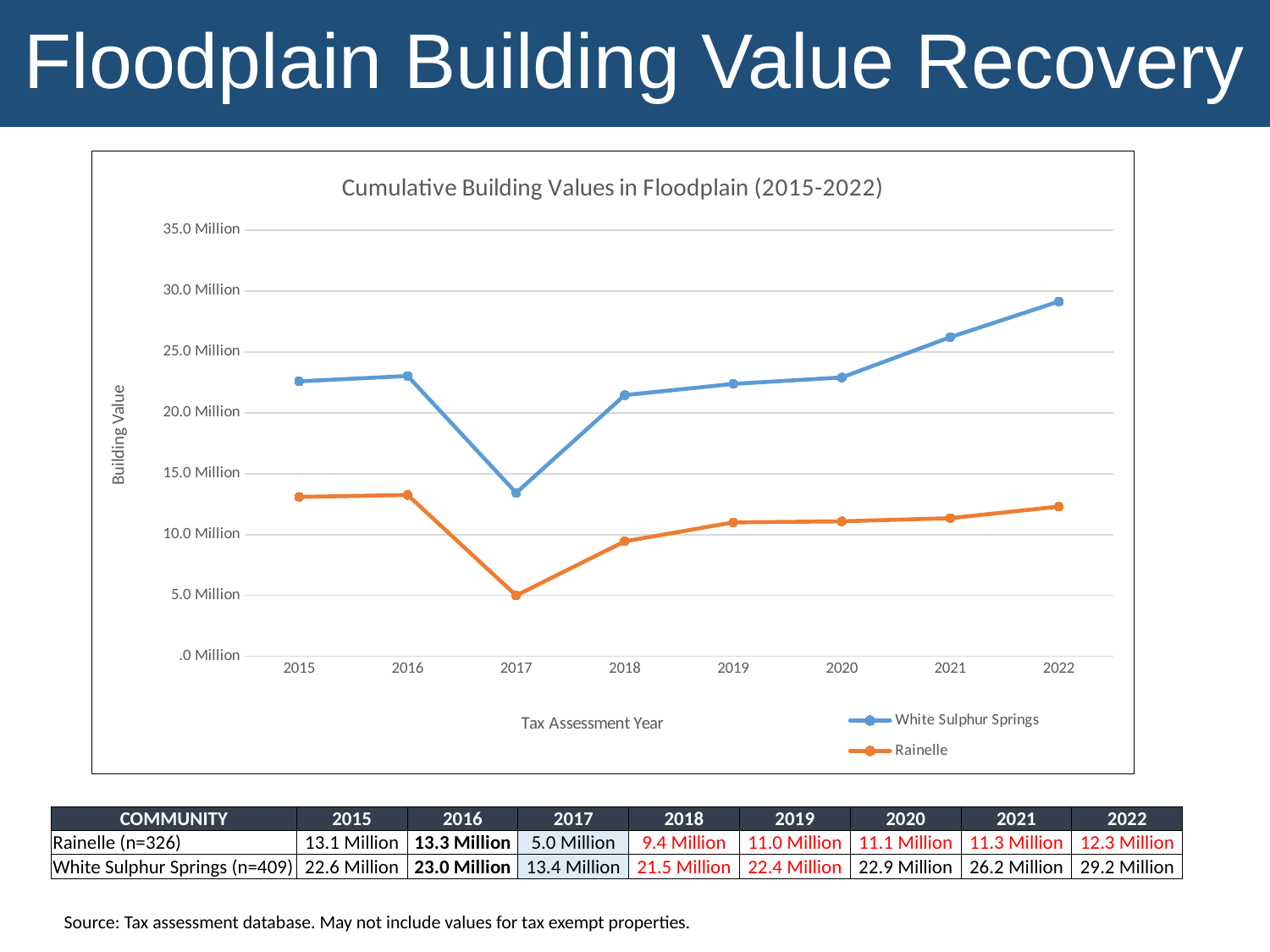
Which community has the larger building value in 2020, White Sulphur Springs or Rainelle? White Sulphur Springs In which year is the Rainelle building value highest? 2016 From 2017 to 2022, does the Rainelle building value rise or fall? rise In which year is the White Sulphur Springs building value lowest? 2017 What kind of chart is shown on the slide? line chart How many series does the chart legend list? 2 Is the White Sulphur Springs building value in 2021 greater or less than 25.0 Million? greater What is the title of the chart? Cumulative Building Values in Floodplain (2015-2022) What is the difference between the White Sulphur Springs and Rainelle building values in 2016? 9.7 Million What is the building value for Rainelle in 2017? 5.0 Million How many years are plotted along the x axis of the chart? 8 What is the building value for White Sulphur Springs in 2022? 29.2 Million